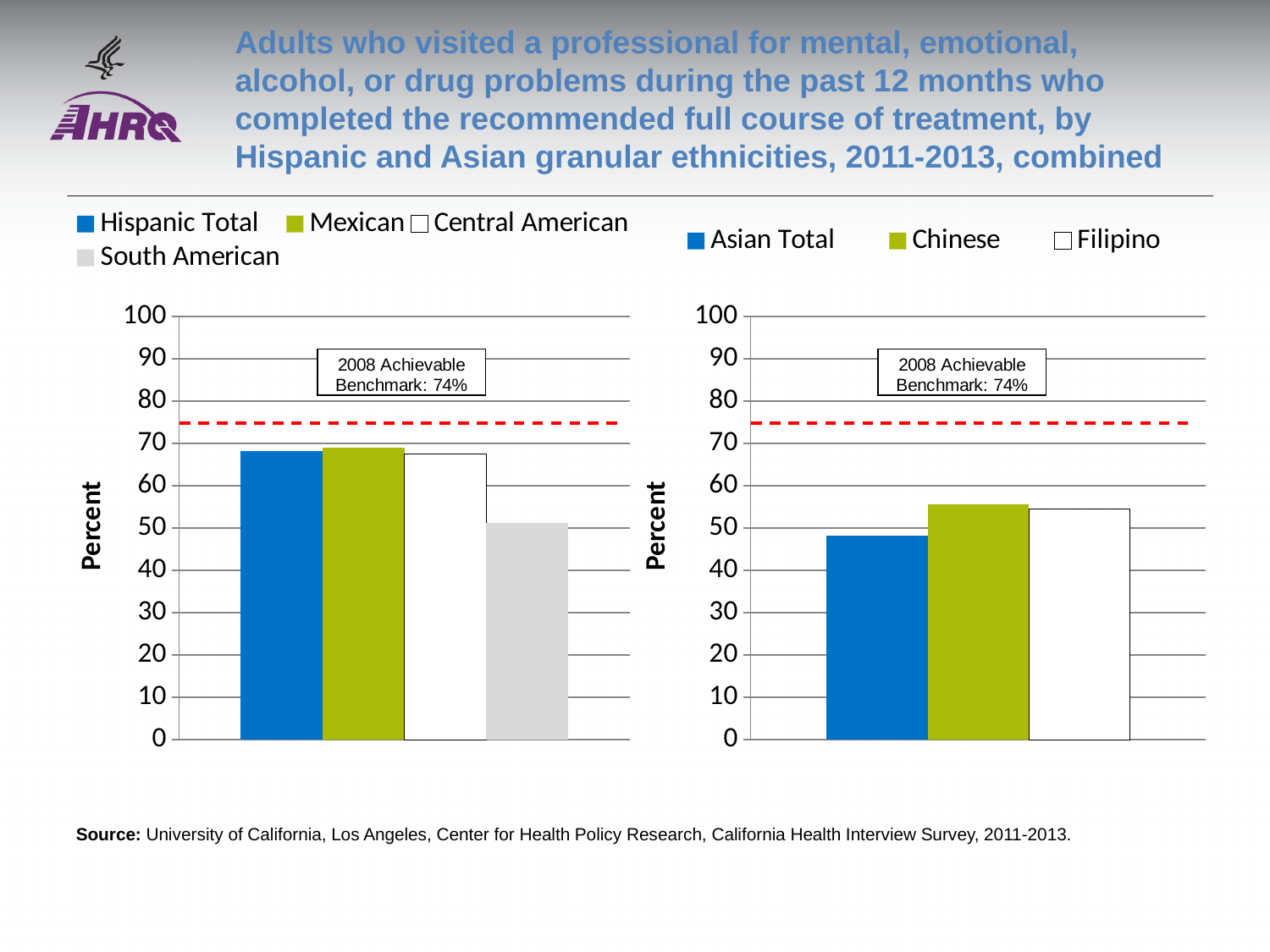
In the right chart (Asian ethnicities), is the value for Filipino greater or less than 60? less In the right chart (Asian ethnicities), is the value for Chinese greater or less than 50? greater In the right chart (Asian ethnicities), which group has the lowest value? Asian Total In the right chart (Asian ethnicities), which is larger, the value for Asian Total or the value for Chinese? Chinese In the left chart (Hispanic ethnicities), which is larger, the value for Mexican or the value for South American? Mexican What kind of chart is the left chart (Hispanic ethnicities)? bar chart In the left chart (Hispanic ethnicities), is the value for Hispanic Total greater or less than 70? less What is the 2008 Achievable Benchmark shown by the dashed line on both charts? 74% In the right chart (Asian ethnicities), how many series does the legend list? 3 In the left chart (Hispanic ethnicities), how many series does the legend list? 4 In the left chart (Hispanic ethnicities), which group has the lowest value? South American